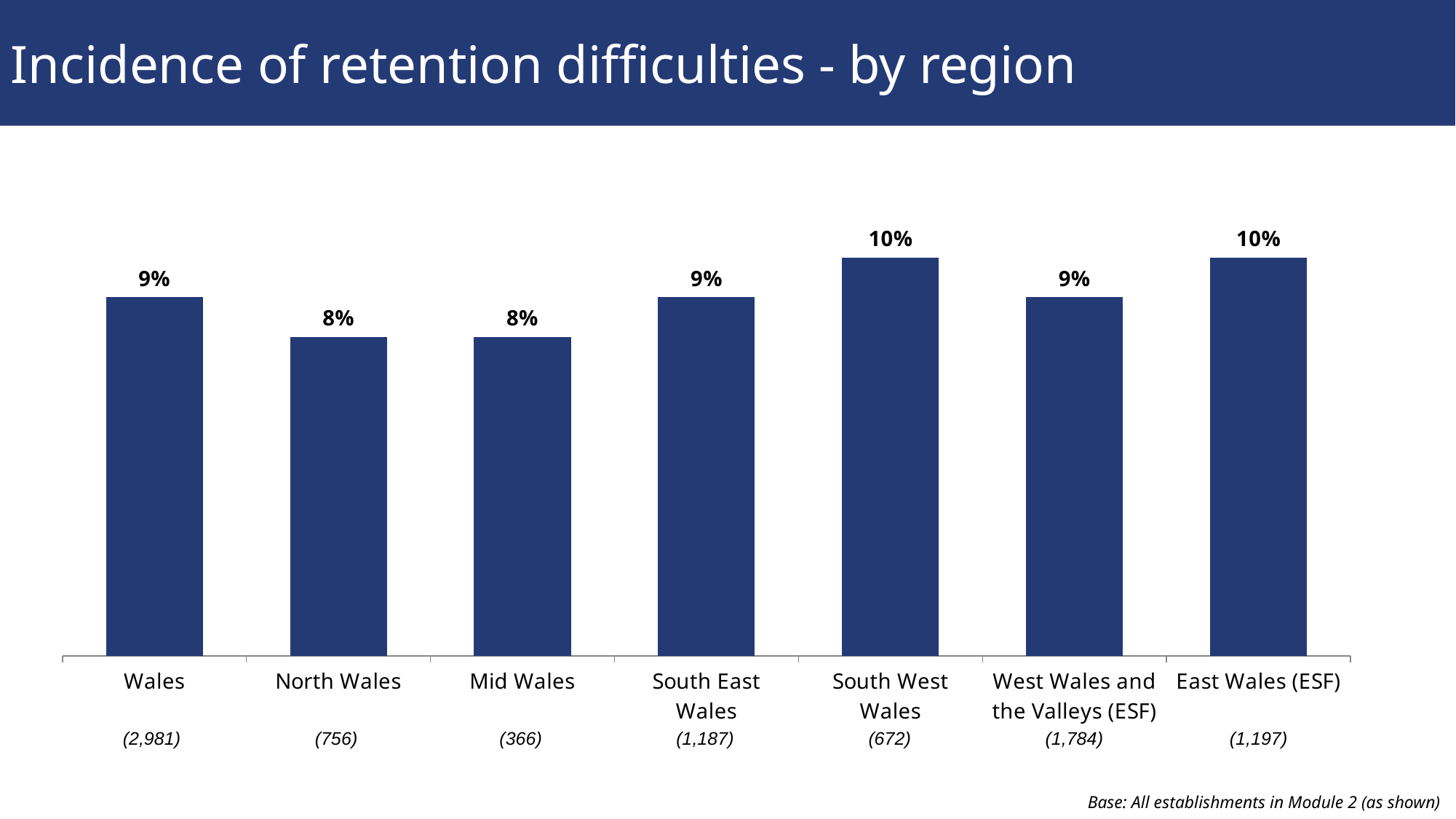
What is the value for Wales? 9% What base number is shown beneath the Mid Wales bar? (366) What is the value for East Wales (ESF)? 10% What is the value for South West Wales? 10% How many regions are shown on the chart? 7 What is the value for North Wales? 8% What is the title of the chart? Incidence of retention difficulties - by region Which regions share the lowest value on the chart? North Wales and Mid Wales What kind of chart is shown on the slide? Bar chart What is the difference between the values for South West Wales and Mid Wales? 2% What is the value for West Wales and the Valleys (ESF)? 9% Which is larger, the value for East Wales (ESF) or the value for North Wales? East Wales (ESF)